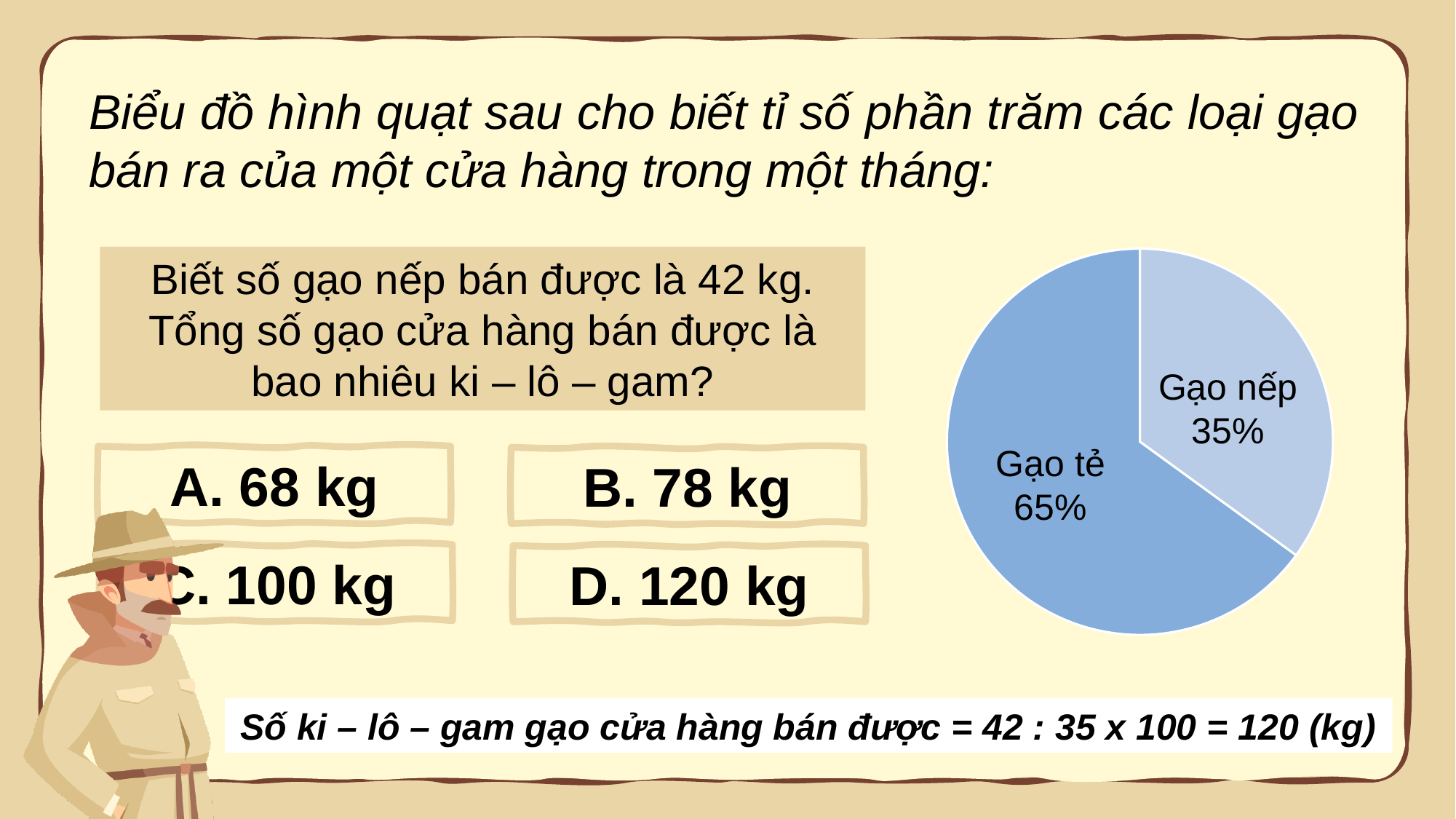
What do the two slices of the pie chart add up to? 100% How many slices does the pie chart have? 2 What percentage does the pie chart show for Gạo nếp? 35% What kind of chart is shown on the slide? pie chart What share of the pie does the Gạo nếp slice represent? 35% Which category has the smallest share of the pie chart? Gạo nếp Is the share for Gạo tẻ greater or less than 50%? greater What colour is the Gạo tẻ slice compared with the Gạo nếp slice? darker blue Which category has the largest share of the pie chart? Gạo tẻ What is the difference in percentage points between Gạo tẻ and Gạo nếp? 30% Which is larger in the pie chart, Gạo nếp or Gạo tẻ? Gạo tẻ What percentage does the pie chart show for Gạo tẻ? 65%